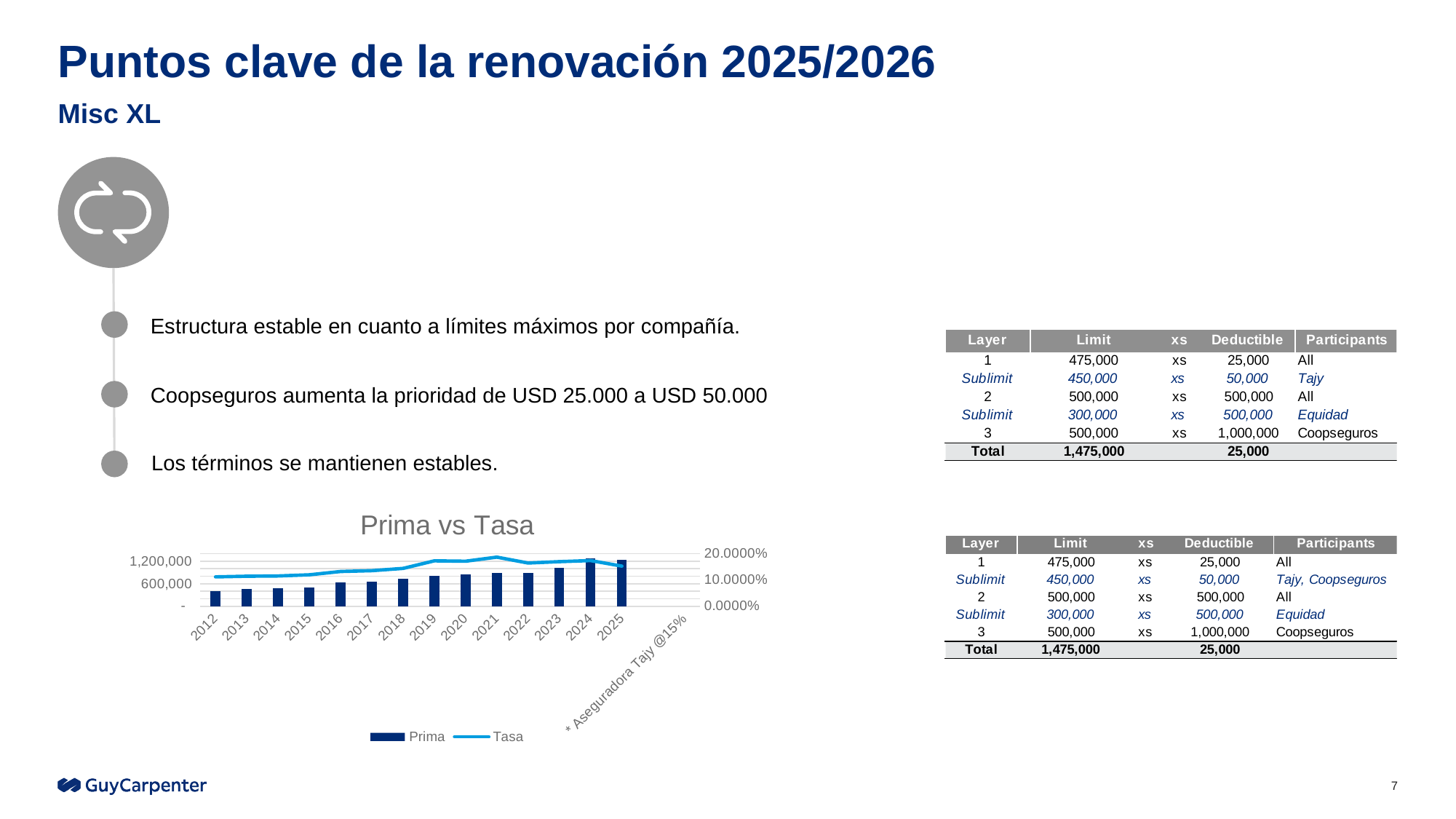
In the Prima vs Tasa chart, which year has the larger Prima bar, 2012 or 2023? 2023 In the Prima vs Tasa chart, is the Tasa value for 2021 greater or less than 10.0000%? greater What kind of chart is Prima vs Tasa? A combined bar and line chart In the Prima vs Tasa chart, which series is drawn as a line? Tasa What is the title of the chart on the slide? Prima vs Tasa In the Prima vs Tasa chart, do the Prima bars generally rise or fall from 2012 to 2024? rise In the Prima vs Tasa chart, is the Prima value for 2012 greater or less than 600,000? less In the Prima vs Tasa chart, which year has the lowest Prima bar? 2012 How many series does the legend of the Prima vs Tasa chart list? 2 In the Prima vs Tasa chart, does the Tasa line generally rise or fall from 2012 to 2021? rise In the Prima vs Tasa chart, is the Prima value for 2024 greater or less than 600,000? greater